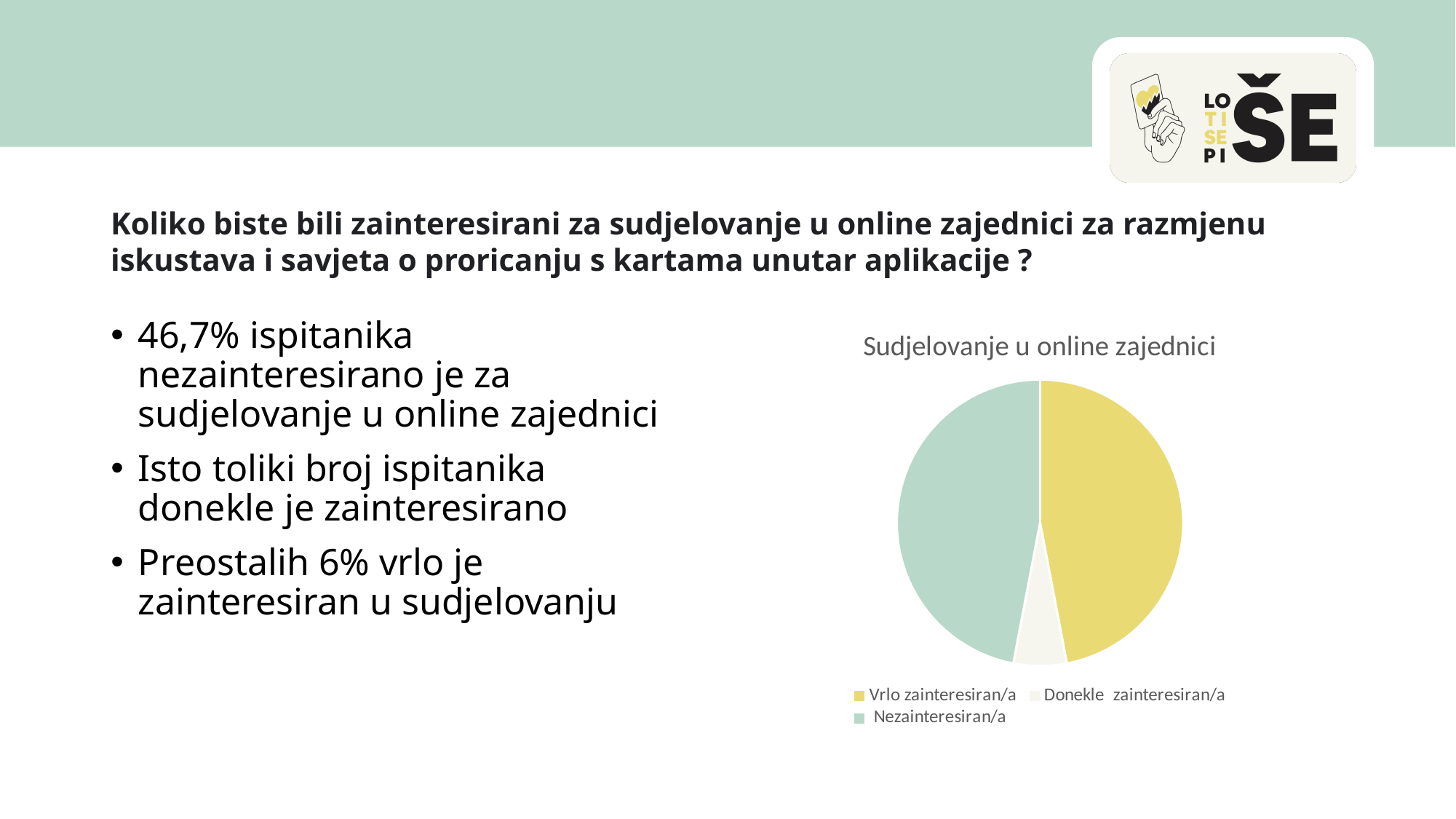
How many slices does the pie chart have? 3 What colour is the Vrlo zainteresiran/a slice in the pie chart? yellow What is the title of the chart? Sudjelovanje u online zajednici Which slice is larger, Nezainteresiran/a or Donekle zainteresiran/a? Nezainteresiran/a How many entries does the chart legend list? 3 What kind of chart is shown on the slide? pie chart Which slice is larger, Vrlo zainteresiran/a or Donekle zainteresiran/a? Vrlo zainteresiran/a Which slice of the pie chart is the smallest? Donekle zainteresiran/a